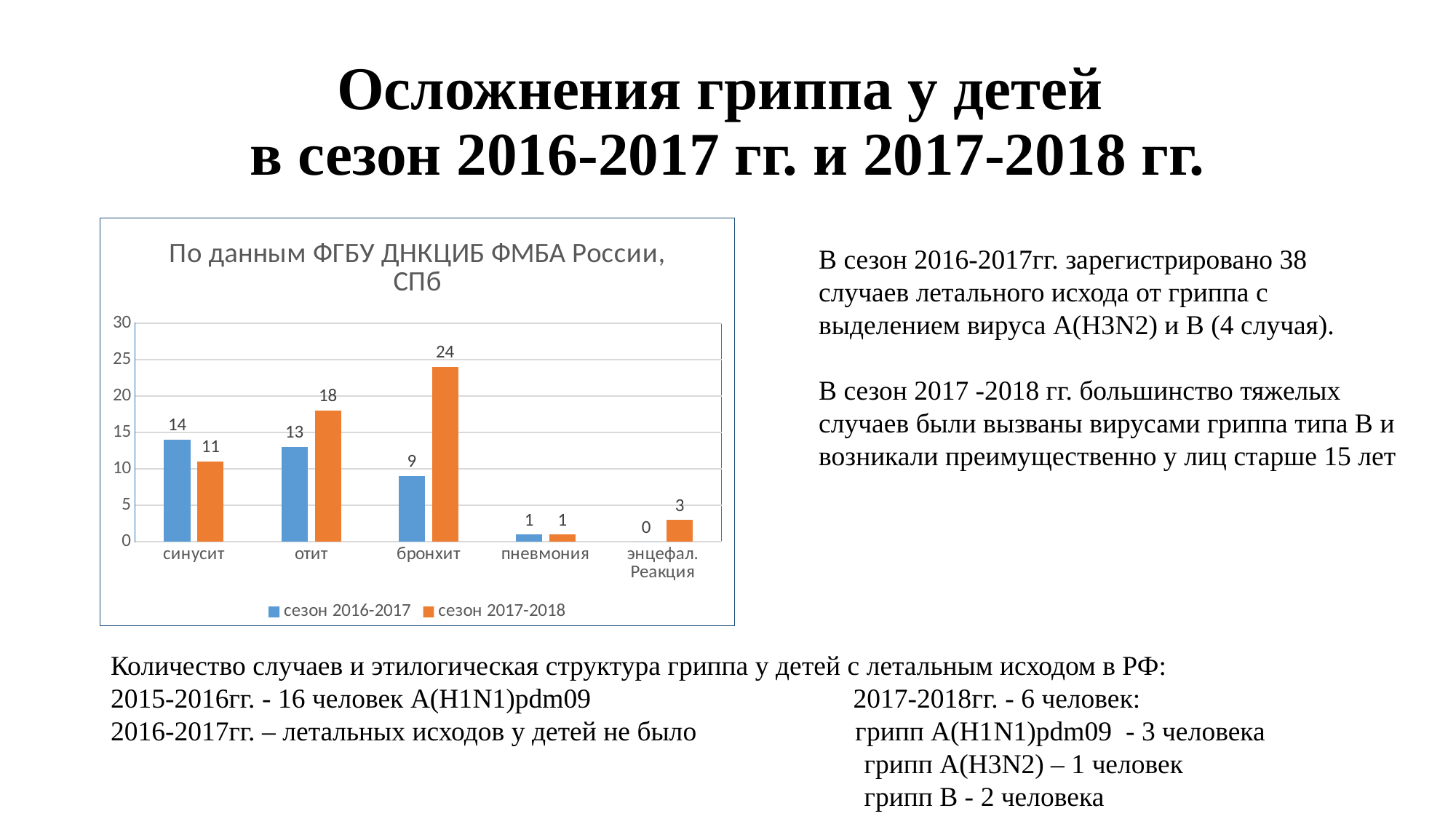
How many series does the legend list? 2 Which category has the lowest value in the сезон 2016-2017 series? энцефал. Реакция What colour are the bars for the сезон 2017-2018 series? orange What is the title of the chart? По данным ФГБУ ДНКЦИБ ФМБА России, СПб What is the value for энцефал. Реакция in the сезон 2016-2017 series? 0 Which category has the highest value in the сезон 2017-2018 series? бронхит What is the difference between the сезон 2017-2018 and сезон 2016-2017 values for бронхит? 15 What is the value for отит in the сезон 2017-2018 series? 18 What is the value for бронхит in the сезон 2016-2017 series? 9 What kind of chart is shown on the slide? bar chart How many categories are shown on the x axis? 5 For синусит, which series has the larger value: сезон 2016-2017 or сезон 2017-2018? сезон 2016-2017